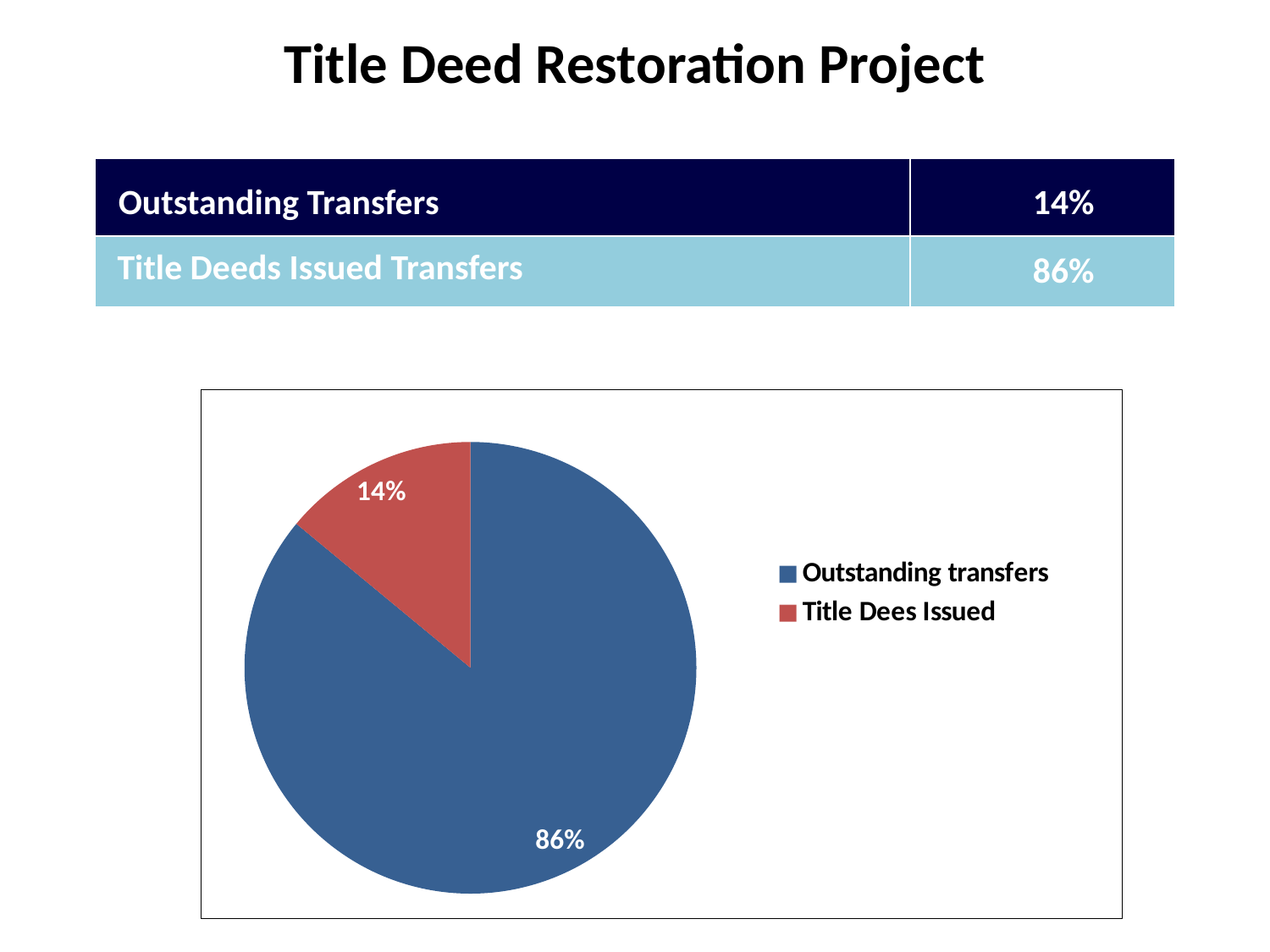
What is the difference in percentage points between the blue slice and the red slice? 72 Which colour slice is the largest in the pie chart? Blue What percentage is shown on the blue slice of the pie chart? 86% Which colour slice is the smallest in the pie chart? Red How many entries does the pie chart's legend list? 2 What type of chart is shown on the slide? Pie chart Which legend entry is shown with a blue marker in the pie chart? Outstanding transfers Which legend entry is shown with a red marker in the pie chart? Title Dees Issued Is the blue slice or the red slice larger in the pie chart? Blue How many slices does the pie chart have? 2 What percentage is shown on the red slice of the pie chart? 14% What share of the pie does the red slice represent? 14%